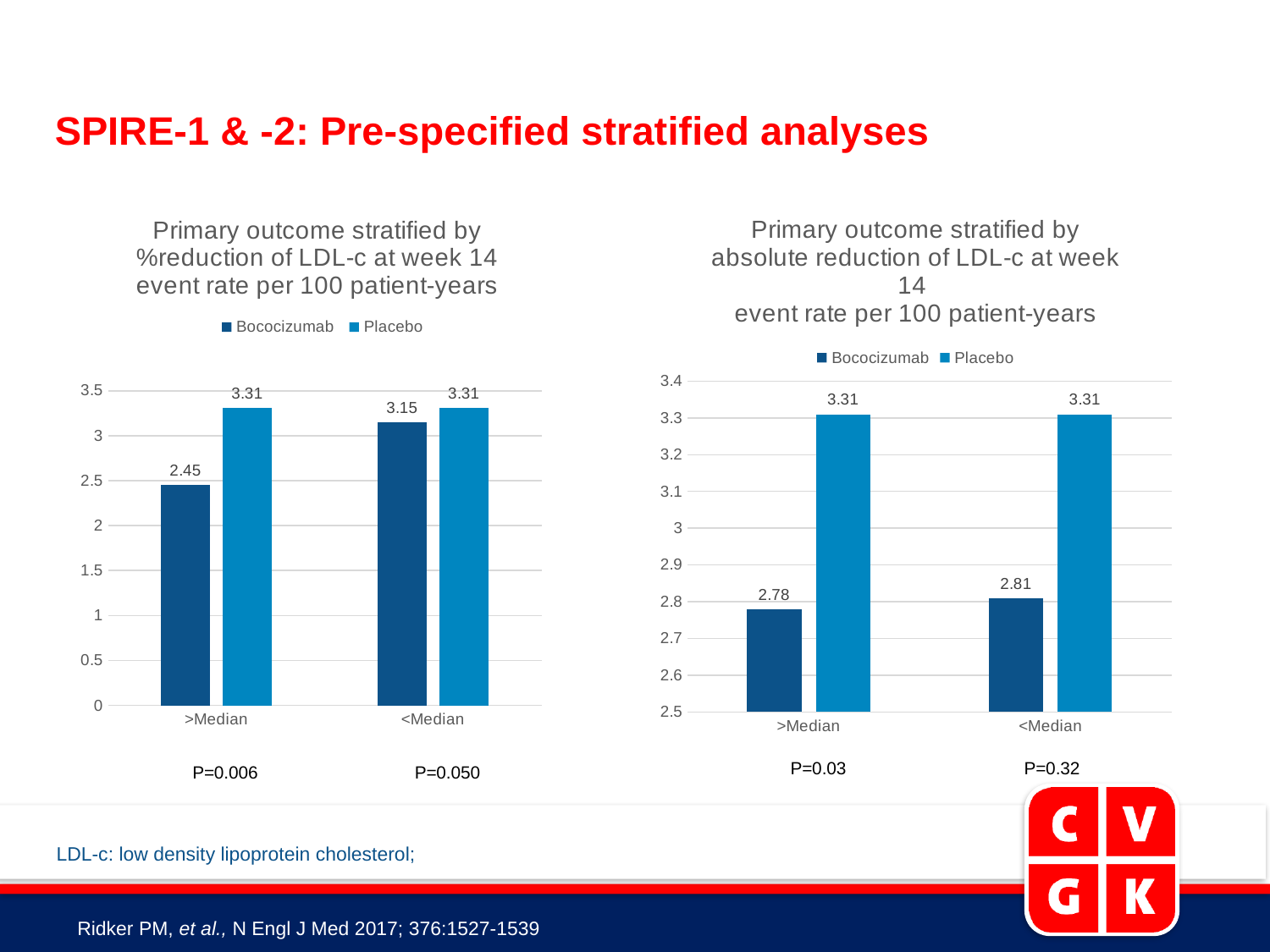
What type of chart is the right chart? Bar chart In the left chart, is the Bococizumab value for the >Median group greater or less than 2.5? less In the right chart, what is the difference between the Placebo and Bococizumab event rates for the <Median group? 0.5 In the left chart (stratified by %reduction of LDL-c), what is the Bococizumab event rate for the >Median group? 2.45 In the right chart (stratified by absolute reduction of LDL-c), what is the Placebo event rate for the <Median group? 3.31 In the right chart (stratified by absolute reduction of LDL-c), what is the Bococizumab event rate for the >Median group? 2.78 In the right chart, which group has the lower Bococizumab event rate, >Median or <Median? >Median In the left chart, what is the difference between the Placebo and Bococizumab event rates for the >Median group? 0.86 How many categories are shown on the x axis of the left chart? 2 In the left chart, is the Bococizumab value for the <Median group larger or smaller than the Placebo value for the same group? smaller How many series does the legend of the right chart list? 2 In the left chart (stratified by %reduction of LDL-c), what is the Bococizumab event rate for the <Median group? 3.15